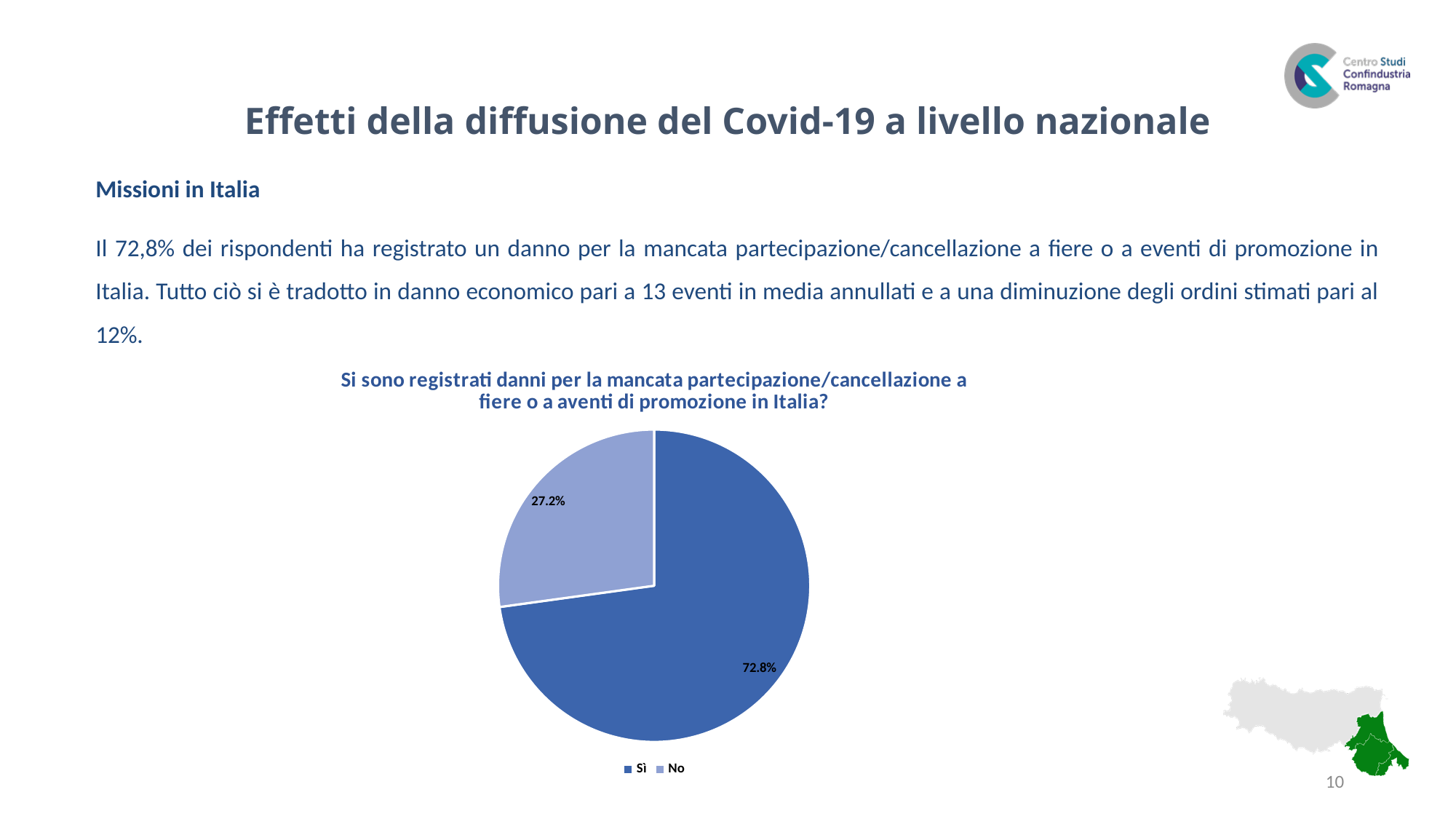
How many slices does the pie chart have? 2 Which legend entry is shown in the lighter blue colour? No What is the difference in percentage points between the "Sì" slice and the "No" slice? 45.6 What share of the pie does the "No" slice represent? 27.2% What is the title of the pie chart? Si sono registrati danni per la mancata partecipazione/cancellazione a fiere o a aventi di promozione in Italia? Which slice of the pie is the largest? Sì Which slice of the pie is the smallest? No What share of the pie does the "Sì" slice represent? 72.8% What kind of chart is shown on the slide? pie chart Which is larger, the "Sì" slice or the "No" slice? Sì How many entries does the legend list? 2